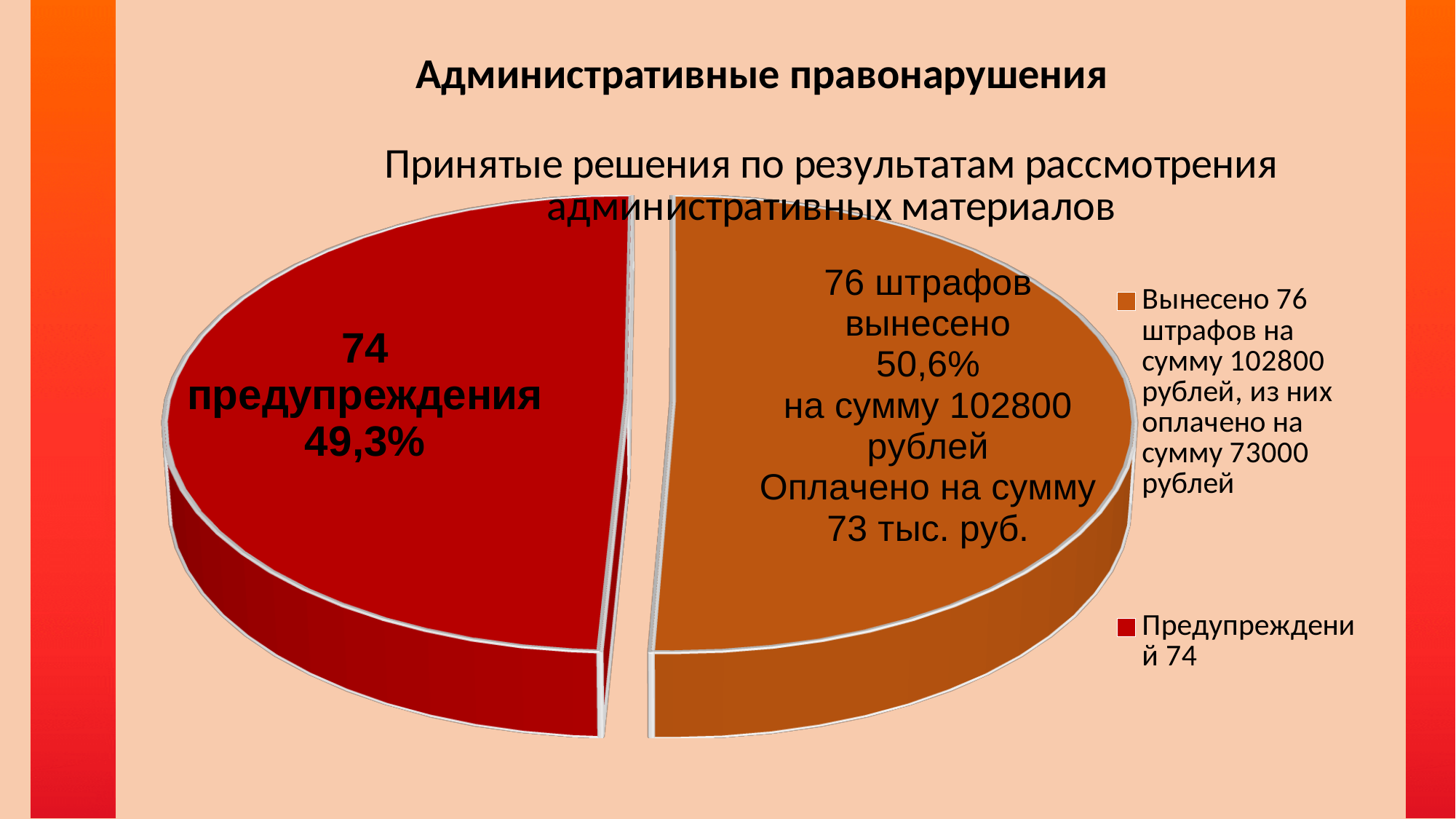
How many fines (штрафов) are shown on the chart? 76 How many slices does the pie chart have? 2 What kind of chart is shown on the slide? Pie chart How many entries does the chart legend list? 2 What percentage share is shown for the warnings (предупреждения) slice? 49,3% What is the title of the chart? Принятые решения по результатам рассмотрения административных материалов What is the difference between the number of fines and the number of warnings? 2 What total amount in rubles were the fines issued for, according to the chart label? 102800 рублей Which slice is larger: warnings or fines? Fines (штрафов) What percentage share is shown for the fines (штрафов) slice? 50,6% How many warnings (предупреждения) are shown on the chart? 74 What colour is the slice representing warnings (предупреждения)? Red